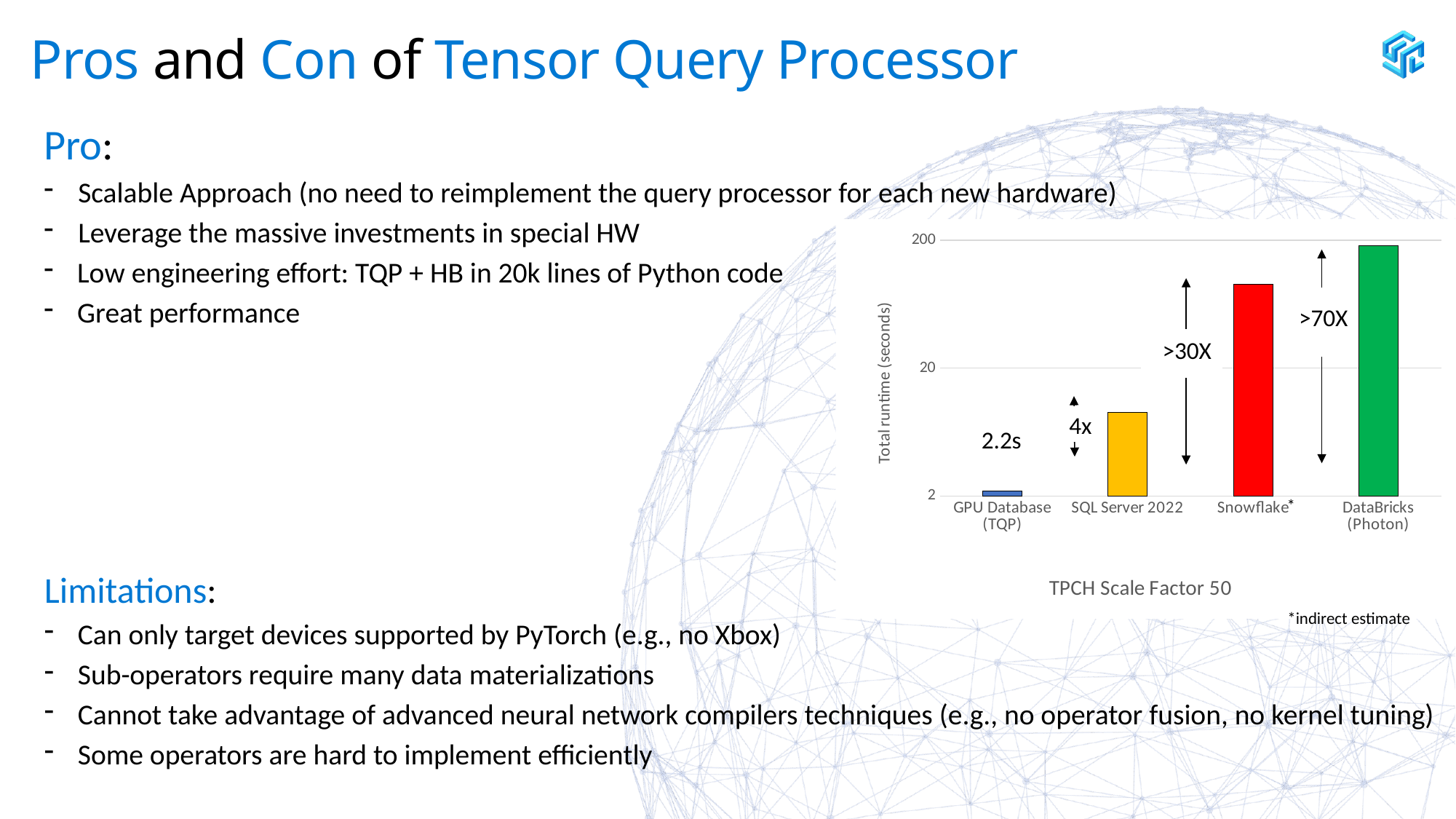
Is the total runtime for Snowflake greater or less than 20 seconds? greater Which system has the lowest total runtime in the chart? GPU Database (TQP) How many systems are compared in the bar chart? 4 What benchmark setting is stated below the chart? TPCH Scale Factor 50 What is the label of the y-axis in the chart? Total runtime (seconds) What is the total runtime shown for GPU Database (TQP)? 2.2s Do the total runtimes rise or fall moving from left to right across the systems? Rise Which system has the highest total runtime in the chart? DataBricks (Photon) What kind of chart is used to compare the total runtimes? Bar chart What speedup factor is annotated between TQP and DataBricks (Photon)? >70X Is the total runtime for SQL Server 2022 greater or less than 20 seconds? less Which has a larger total runtime, Snowflake or SQL Server 2022? Snowflake